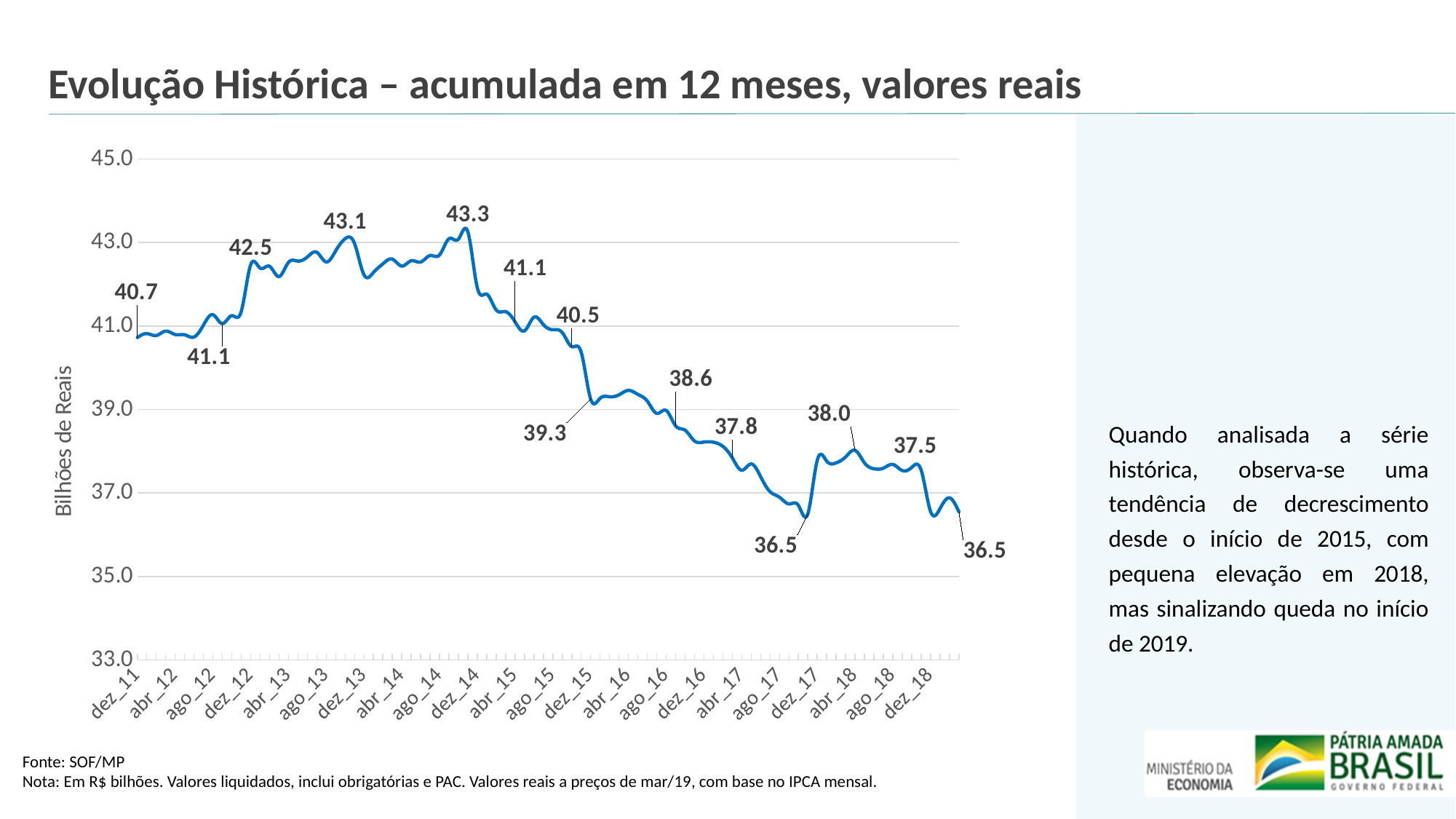
What is the labeled value at the first point of the series (dez_11)? 40.7 What is the lowest labeled value on the line? 36.5 Overall, does the series rise or fall from dez_11 to the end of the period? fall What is the difference between the first labeled value (40.7) and the last labeled value (36.5)? 4.2 What is the difference between the highest labeled value (43.3) and the lowest labeled value (36.5)? 6.8 Is the value for dez_13 greater or less than 41.0? greater What is the highest labeled value on the line? 43.3 Which is larger, the value at dez_11 or the value at the last point of the series? dez_11 What is the label on the vertical axis? Bilhões de Reais What is the labeled value at the last point of the series? 36.5 What kind of chart is shown on the slide? line chart